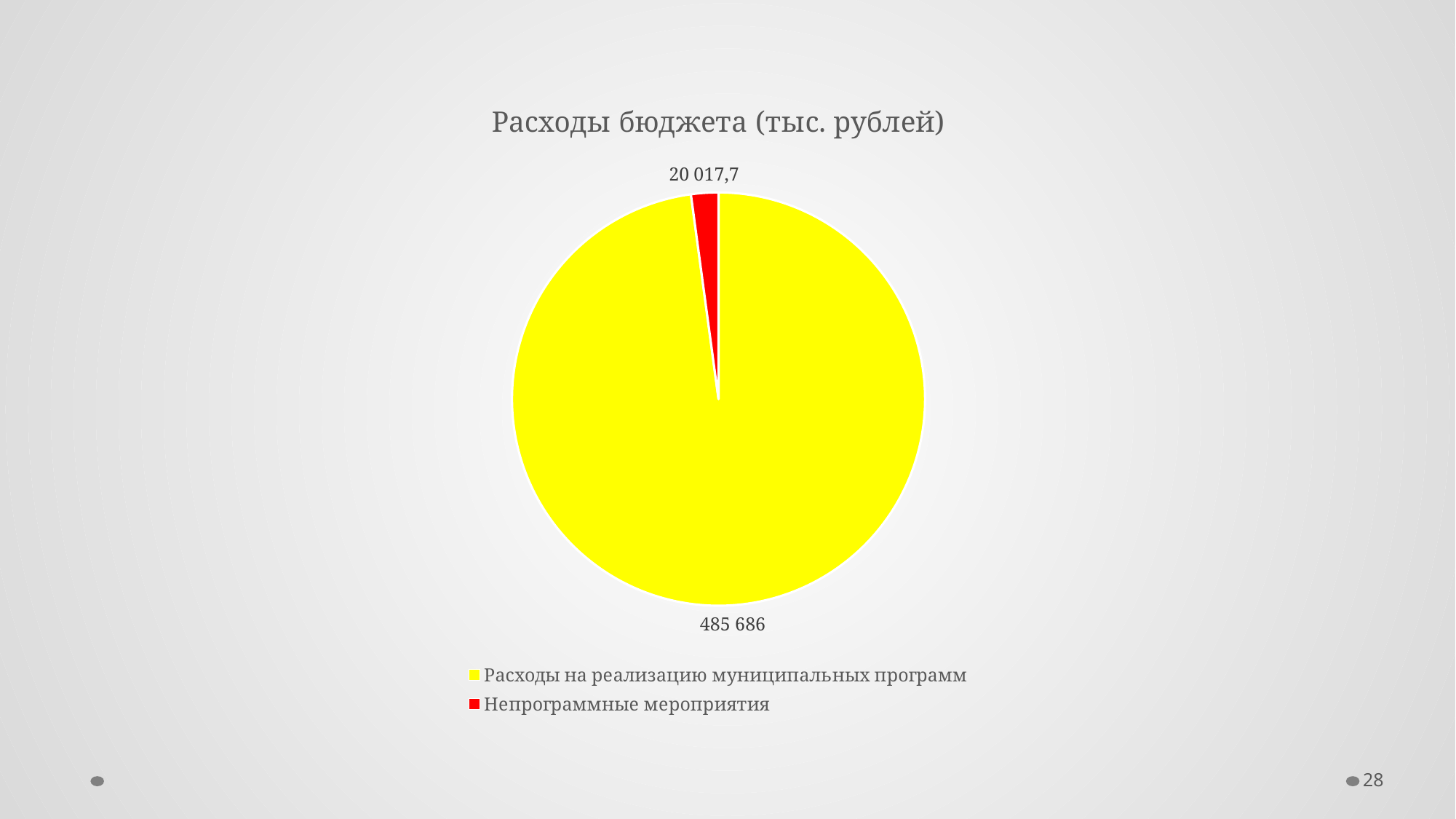
Which is larger: Расходы на реализацию муниципальных программ or Непрограммные мероприятия? Расходы на реализацию муниципальных программ What is the value for Расходы на реализацию муниципальных программ? 485 686 What is the value for Непрограммные мероприятия? 20 017,7 What colour is the slice for Непрограммные мероприятия? red What is the total of the two slices in the pie chart? 505 703,7 Which category has the smallest slice of the pie? Непрограммные мероприятия Which category has the largest slice of the pie? Расходы на реализацию муниципальных программ How many slices does the pie chart have? 2 How many entries does the legend list? 2 What type of chart is shown on the slide? pie chart What is the title of the chart? Расходы бюджета (тыс. рублей) What is the difference between the values for Расходы на реализацию муниципальных программ and Непрограммные мероприятия? 465 668,3